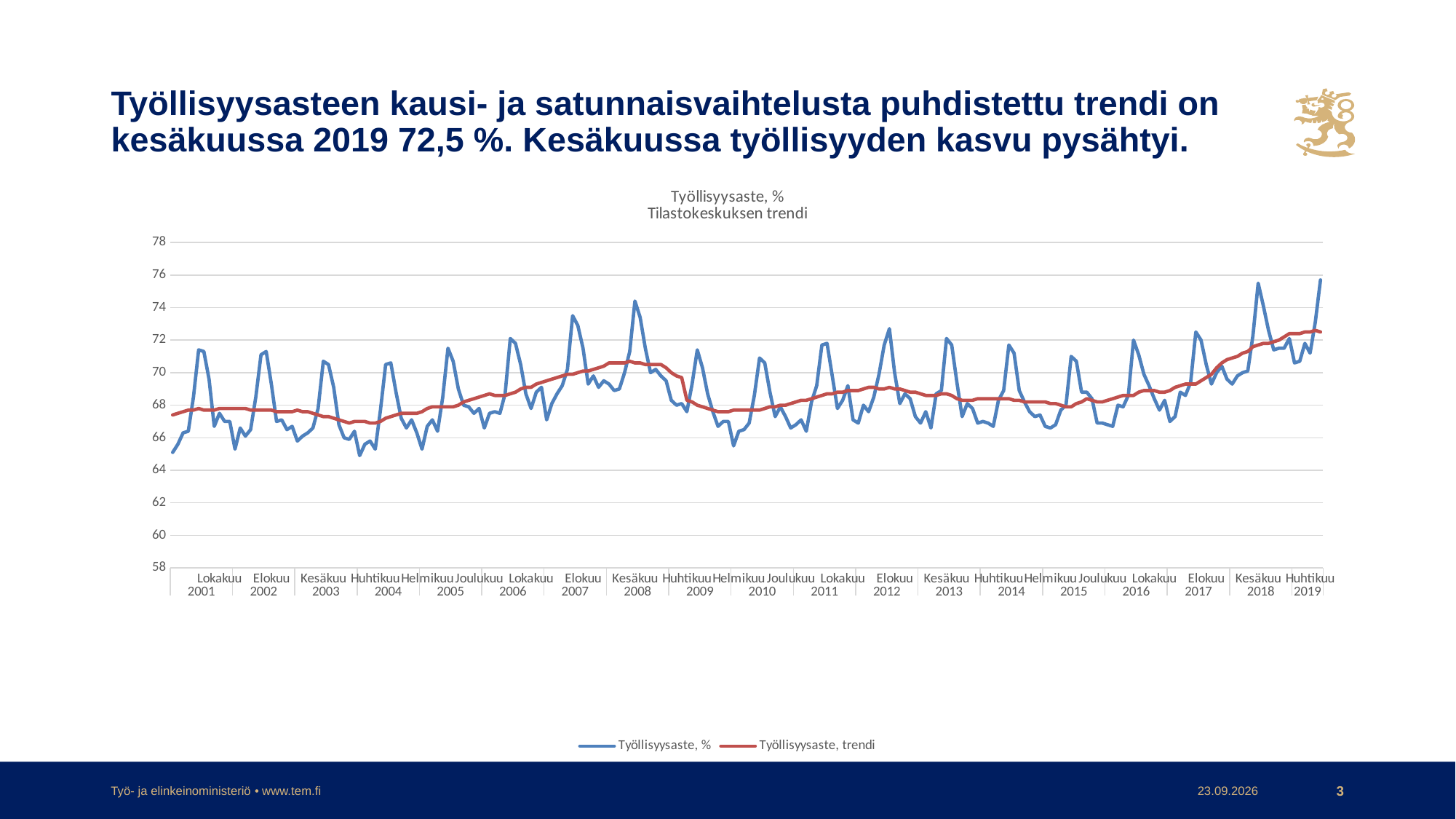
Does the Työllisyysaste, trendi line rise or fall between 2016 and 2019? rise What kind of chart is shown on the slide? line chart Does the Työllisyysaste, trendi line rise or fall between Kesäkuu 2008 and Huhtikuu 2009? fall What is the title of the chart? Työllisyysaste, % Tilastokeskuksen trendi How many series does the legend list? 2 Which is larger for the Työllisyysaste, trendi line: the value at Huhtikuu 2019 or the value at Huhtikuu 2004? Huhtikuu 2019 Is the Työllisyysaste, trendi value around Kesäkuu 2008 greater or less than 70? greater Is the Työllisyysaste, % value at Huhtikuu 2019 greater or less than 74? less Is the Työllisyysaste, trendi value around Huhtikuu 2004 greater or less than 68? less What are the two series named in the legend? Työllisyysaste, % and Työllisyysaste, trendi According to the slide, what is the seasonally adjusted employment rate trend in June 2019? 72,5 %